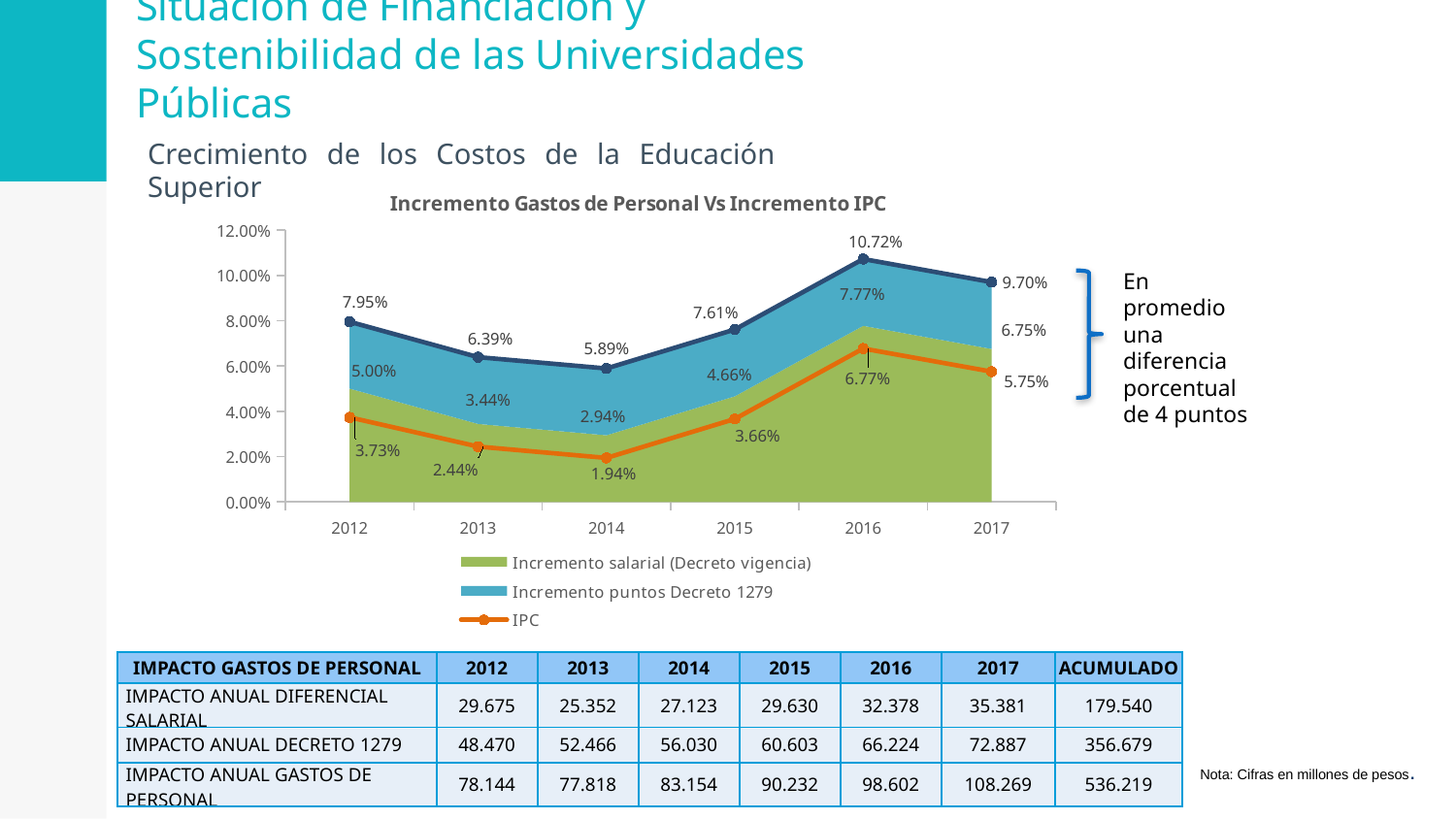
In which year is the IPC value the highest? 2016 What is the title of the chart on the slide? Incremento Gastos de Personal Vs Incremento IPC Which is larger, the IPC value for 2012 or for 2015? 2012 In which year is the IPC value the lowest? 2014 What is the total value at the top of the stacked area for 2012? 7.95% What is the total value at the top of the stacked area for 2016? 10.72% What is the IPC value for 2016? 6.77% How many series does the chart legend list? 3 How many years are shown on the x axis of the chart? 6 What is the difference between the IPC values for 2016 and 2014? 4.83% Does the IPC line rise or fall from 2012 to 2014? fall What is the IPC value for 2014? 1.94%